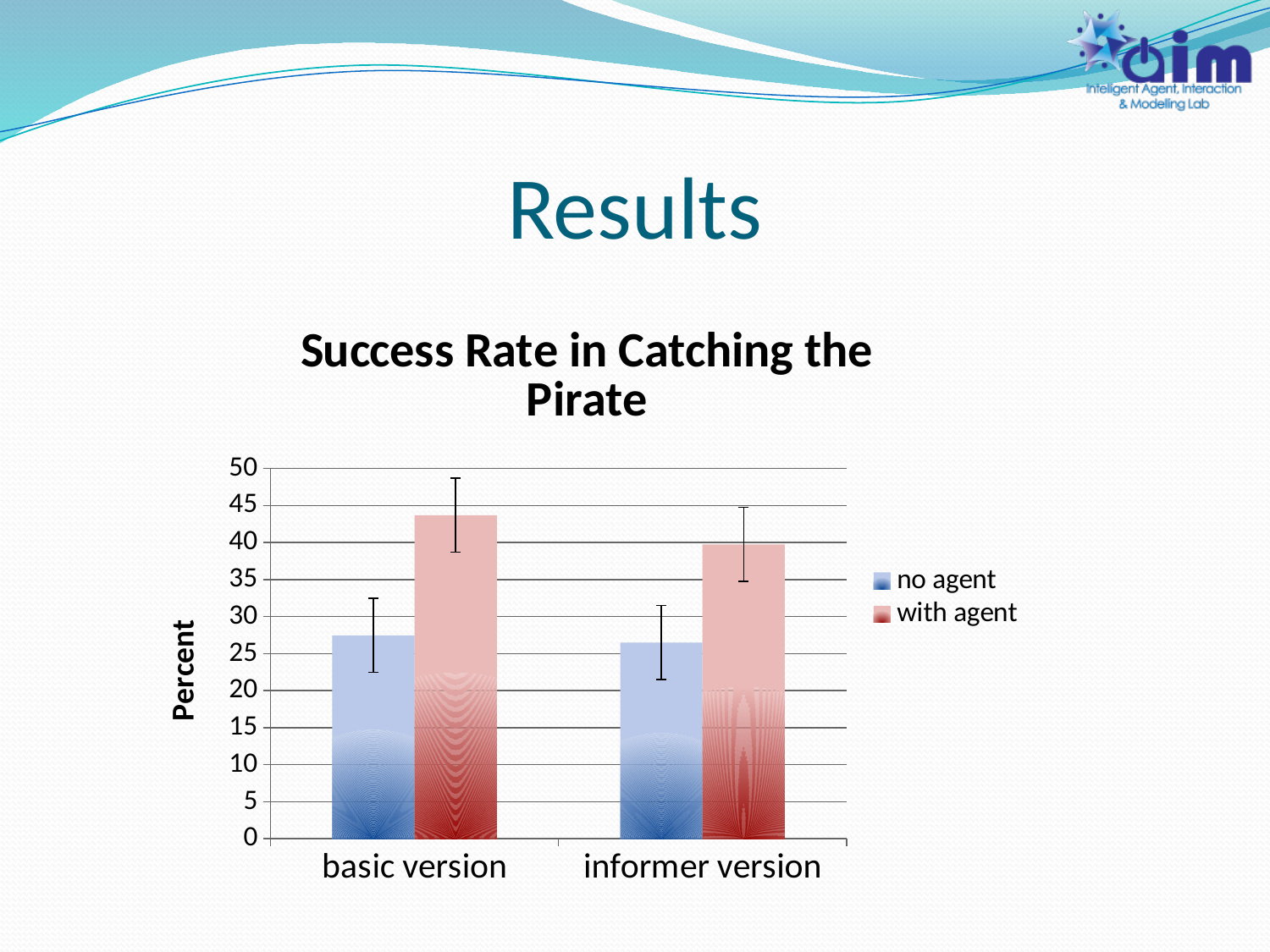
Is the value for with agent in the basic version greater or less than 40? greater Which bar is the highest in the chart? with agent, basic version For the with agent series, which version has the higher value? basic version How many categories are shown on the x axis? 2 In the basic version, which is larger: the value for no agent or the value for with agent? with agent In the informer version, which is larger: the value for no agent or the value for with agent? with agent What kind of chart is shown on the slide? bar chart Is the value for with agent in the informer version greater or less than 35? greater How many series does the legend list? 2 Is the value for no agent in the basic version greater or less than 30? less What is the title of the chart? Success Rate in Catching the Pirate What is the label of the vertical axis? Percent